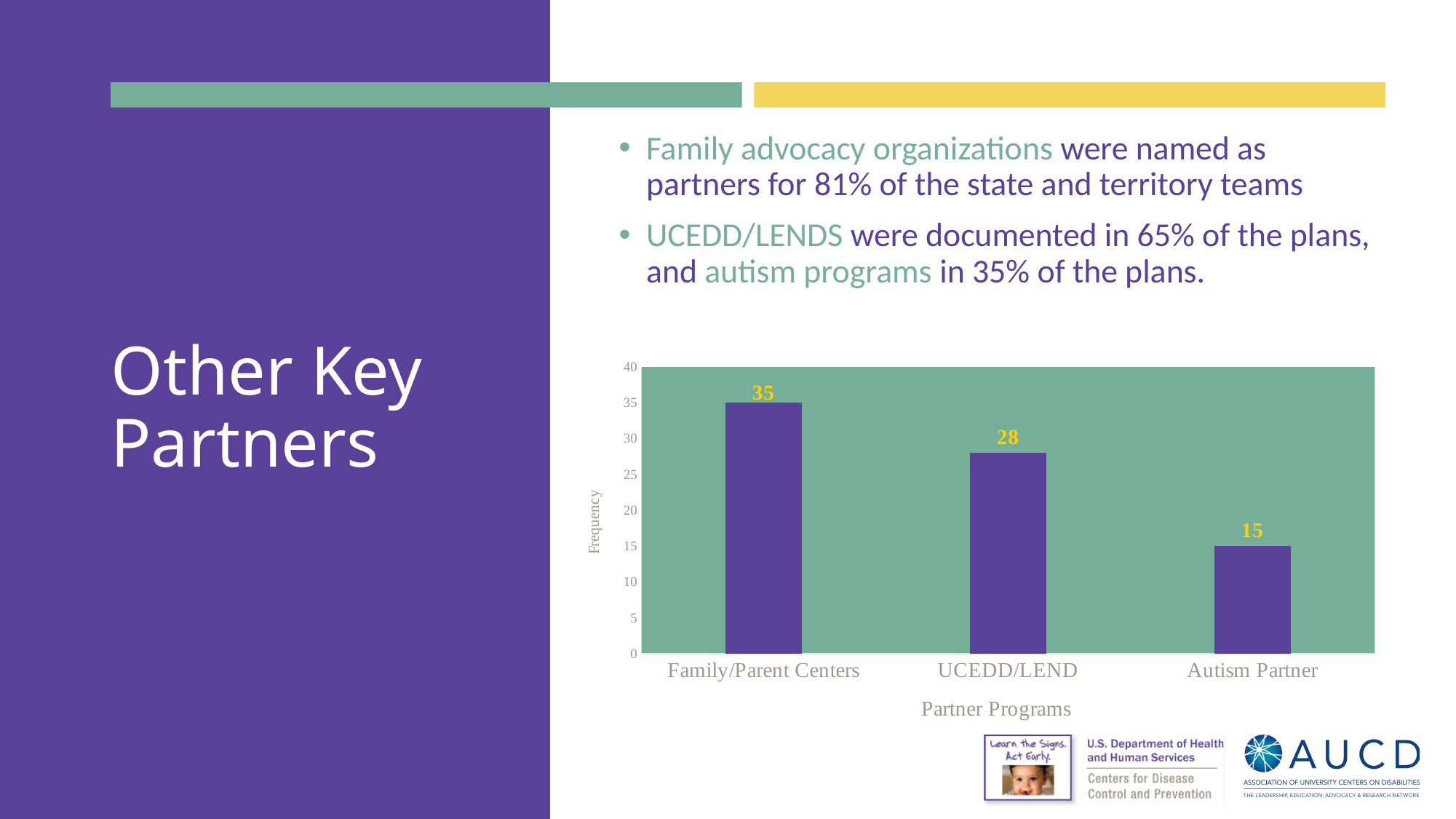
What is the difference in frequency between UCEDD/LEND and Autism Partner? 13 How many partner programs are shown on the chart? 3 Which has a higher frequency, UCEDD/LEND or Autism Partner? UCEDD/LEND Which partner program has the highest frequency? Family/Parent Centers Is the frequency for Autism Partner greater or less than 20? less What is the label of the x axis of the chart? Partner Programs What is the frequency for Autism Partner? 15 What is the frequency for Family/Parent Centers? 35 What is the frequency for UCEDD/LEND? 28 What is the difference in frequency between Family/Parent Centers and UCEDD/LEND? 7 What kind of chart is shown on the slide? Bar chart Which partner program has the lowest frequency? Autism Partner